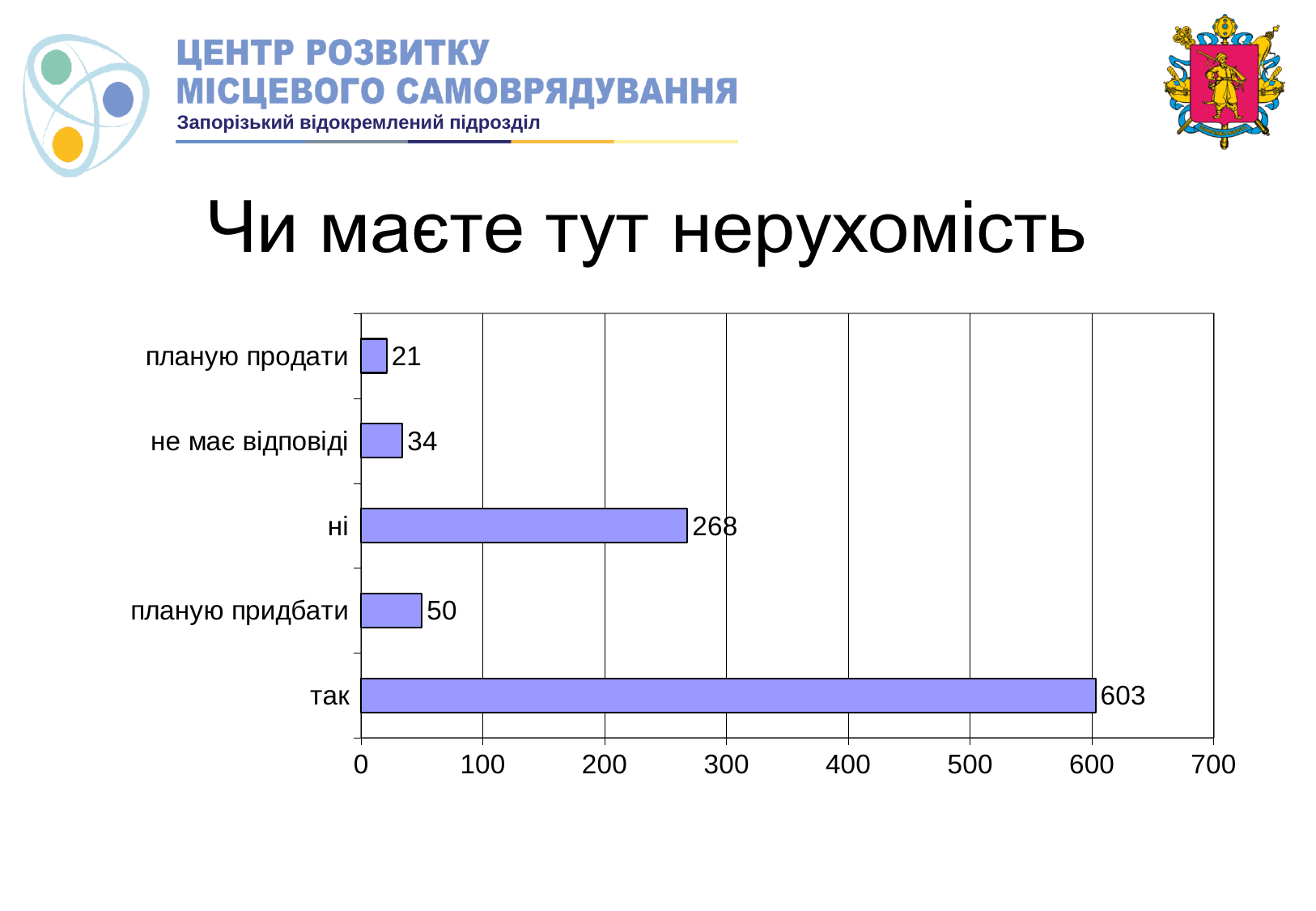
What is the title of the slide above the chart? Чи маєте тут нерухомість What is the difference between the values for "так" and "ні"? 335 What is the value for "ні"? 268 Which category has the highest value? так Which category has the lowest value? планую продати What kind of chart is shown on the slide? bar chart What is the value for "планую придбати"? 50 How many categories are shown in the chart? 5 What is the value for "не має відповіді"? 34 What is the value for "планую продати"? 21 Which is larger, the value for "планую придбати" or the value for "не має відповіді"? планую придбати What is the value for "так"? 603